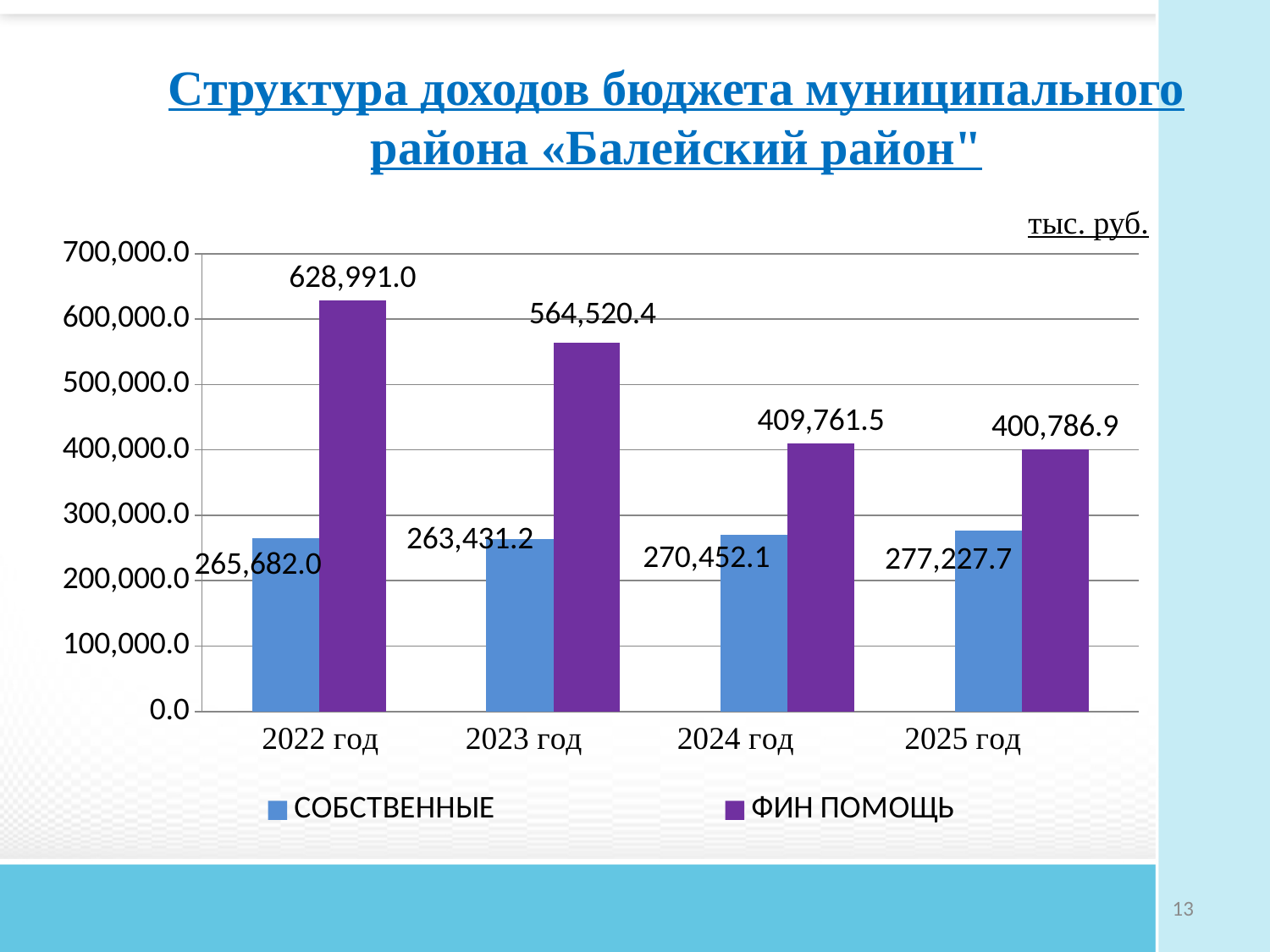
What is the value for ФИН ПОМОЩЬ in 2024 год? 409,761.5 Does ФИН ПОМОЩЬ rise or fall from 2022 год to 2025 год? fall What is the difference between ФИН ПОМОЩЬ in 2024 год and in 2025 год? 8,974.6 In which year is СОБСТВЕННЫЕ lowest? 2023 год Which is larger in 2023 год: СОБСТВЕННЫЕ or ФИН ПОМОЩЬ? ФИН ПОМОЩЬ In which year is ФИН ПОМОЩЬ lowest? 2025 год How many series does the legend list? 2 How many years are shown on the x axis? 4 What is the value for СОБСТВЕННЫЕ in 2025 год? 277,227.7 What is the value for ФИН ПОМОЩЬ in 2022 год? 628,991.0 What is the difference between ФИН ПОМОЩЬ and СОБСТВЕННЫЕ in 2022 год? 363,309.0 In which year is ФИН ПОМОЩЬ highest? 2022 год